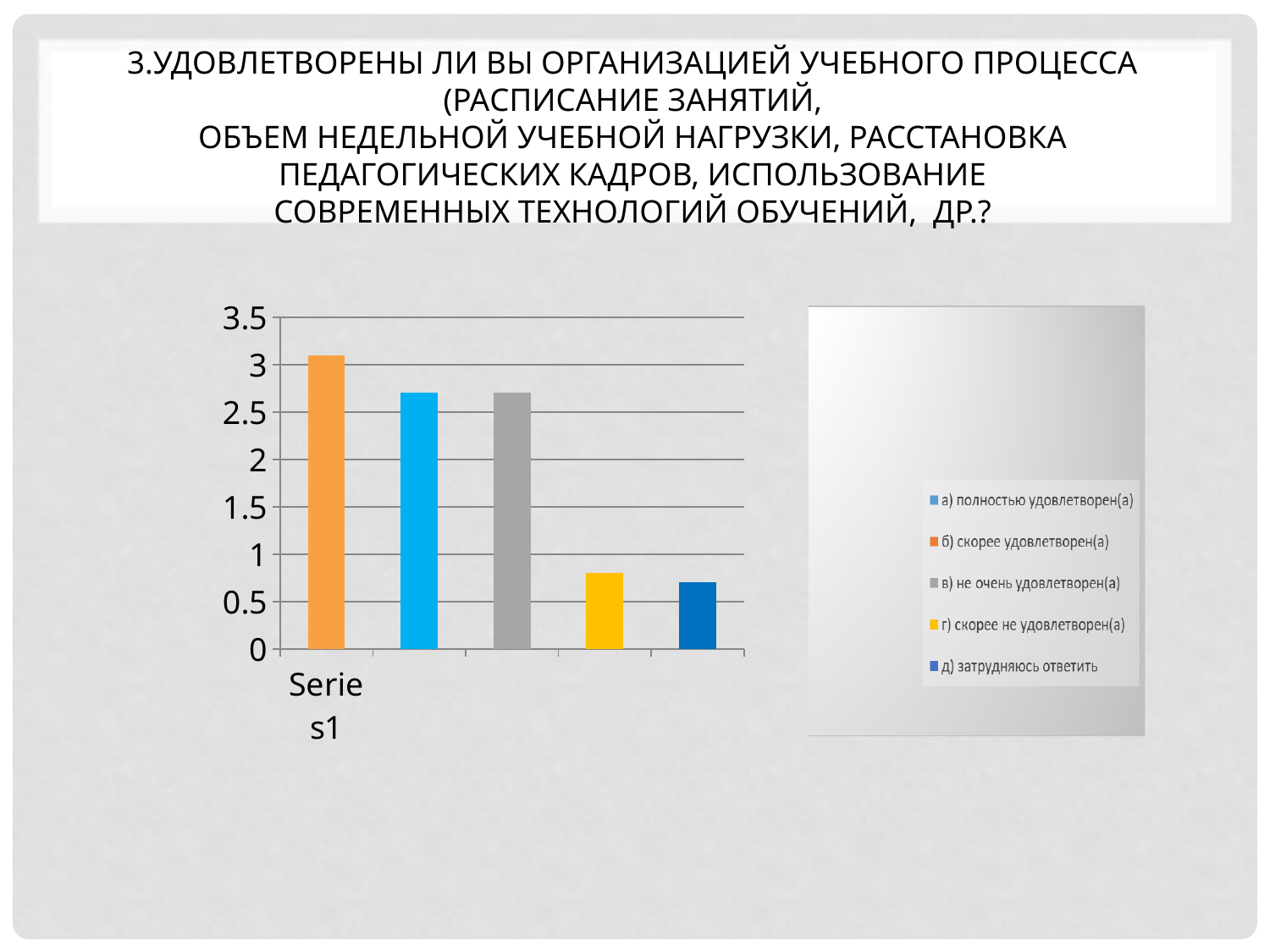
How many entries does the legend list? 5 Which bar is the tallest in the chart? the orange bar (first bar) What kind of chart is shown on the slide? bar chart What is the highest value shown on the vertical axis? 3.5 Is the value of the orange (first) bar greater or less than 3? greater What legend entry is shown in yellow? г) скорее не удовлетворен(а) Which is larger, the gray (third) bar or the yellow (fourth) bar? the gray bar How many bars are plotted in the chart? 5 Is the value of the dark blue (fifth) bar greater or less than 1? less Is the value of the light blue (second) bar greater or less than 2.5? greater Which is larger, the orange (first) bar or the gray (third) bar? the orange bar